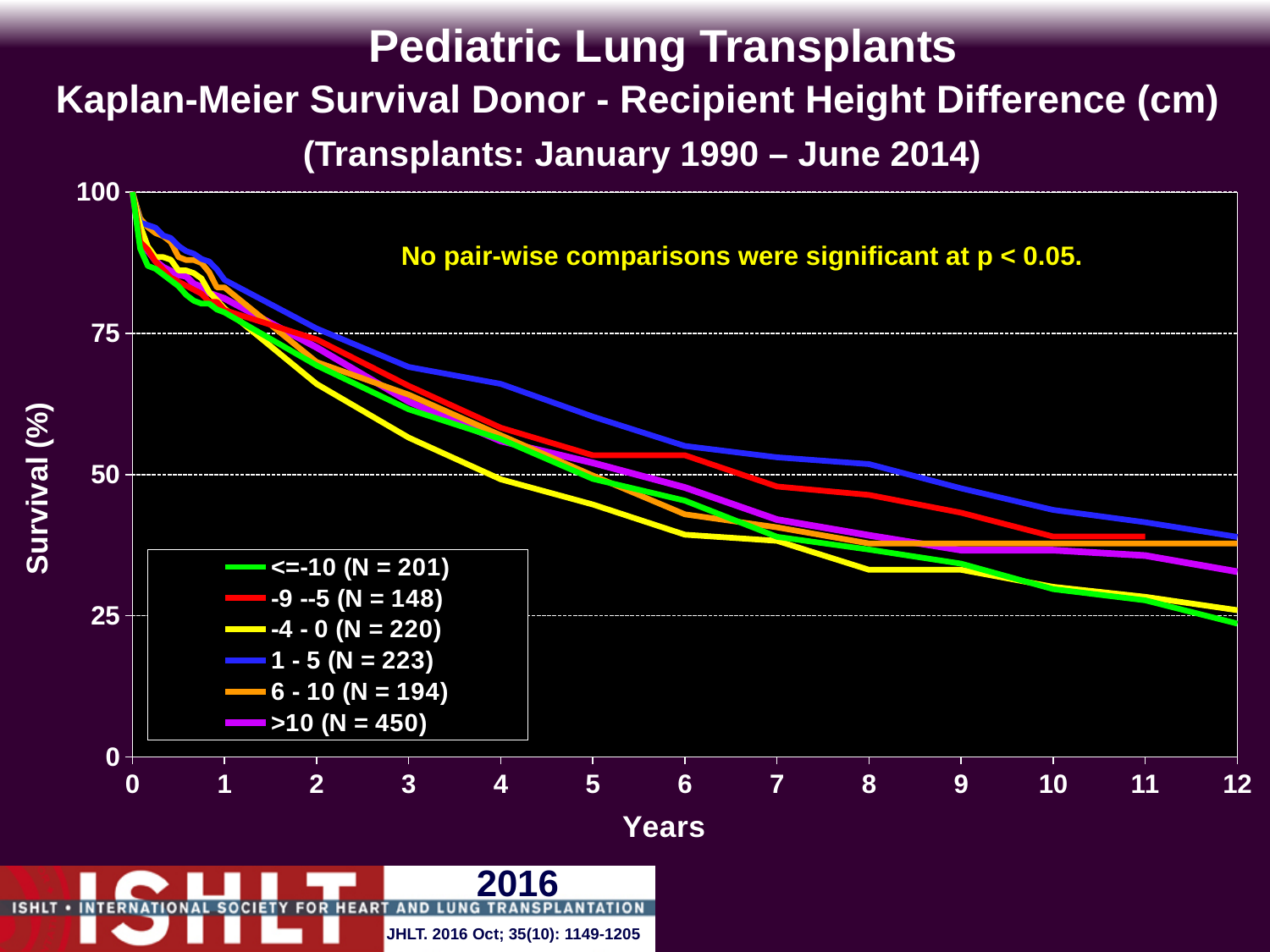
How many groups does the legend list? 6 Which group has the smallest N in the legend? -9 --5 (N = 148) What is the N for the >10 height-difference group? 450 What does the yellow annotation on the chart say? No pair-wise comparisons were significant at p < 0.05. Which group has the largest N in the legend? >10 (N = 450) Is the survival for the 1 - 5 group at year 6 greater or less than 50? greater Is the survival for the -4 - 0 group at year 8 greater or less than 50? less Do the survival curves rise or fall as years increase? fall What is the survival (%) for all groups at year 0? 100 At year 8, which group has higher survival: 1 - 5 or -4 - 0? 1 - 5 What is the N for the -9 --5 height-difference group? 148 What kind of chart is shown on the slide? line chart